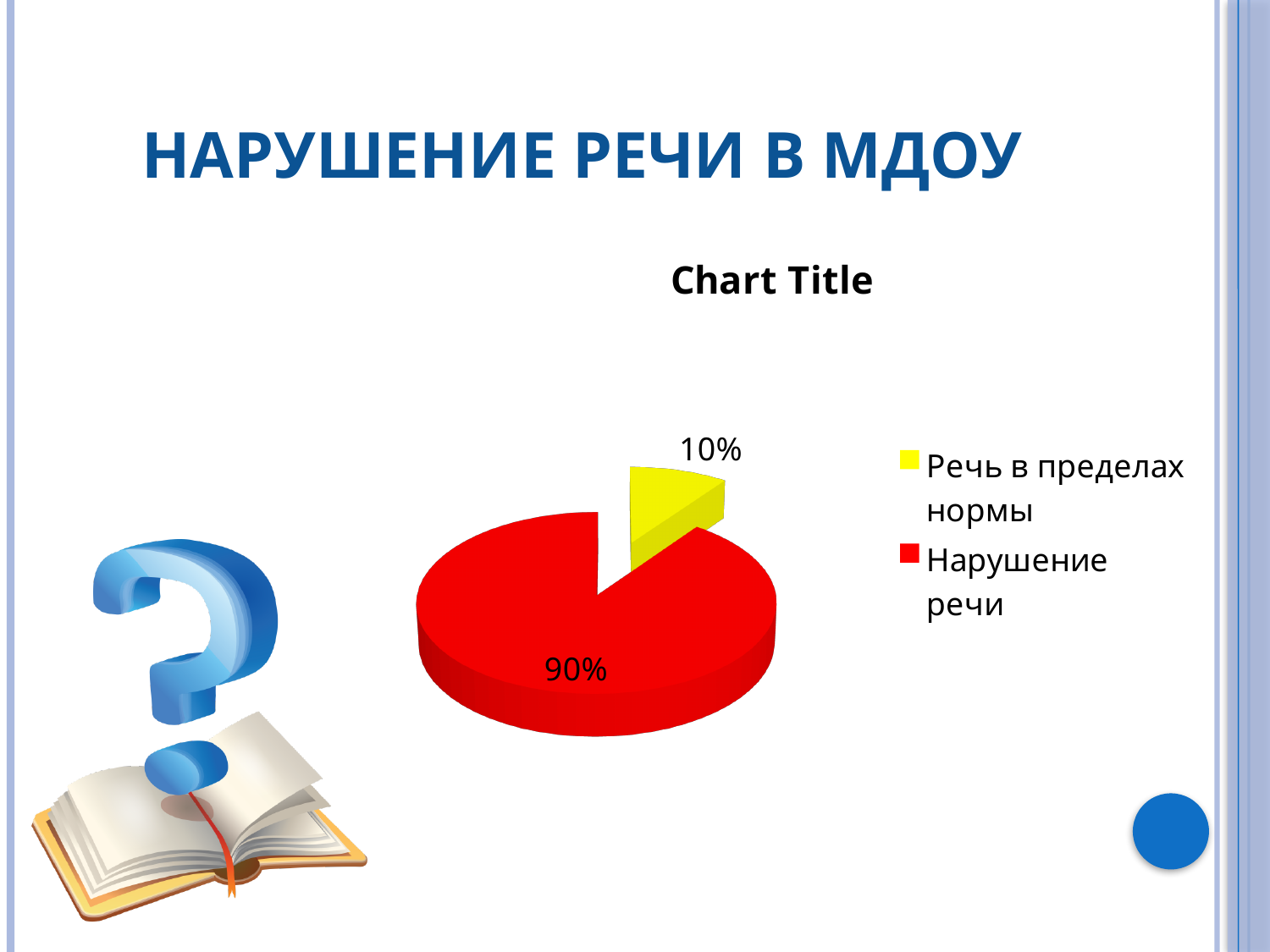
What is the difference in percentage points between the "Нарушение речи" slice and the "Речь в пределах нормы" slice? 80 What kind of chart is shown on the slide? pie chart How many entries does the legend list? 2 Which is larger: the "Речь в пределах нормы" slice or the "Нарушение речи" slice? Нарушение речи What share of the pie does "Речь в пределах нормы" take? 10% What share of the pie does "Нарушение речи" take? 90% Which slice of the pie is the largest? Нарушение речи What is the title shown above the pie chart? Chart Title What colour is the "Нарушение речи" slice? red Which slice of the pie is the smallest? Речь в пределах нормы How many slices does the pie chart have? 2